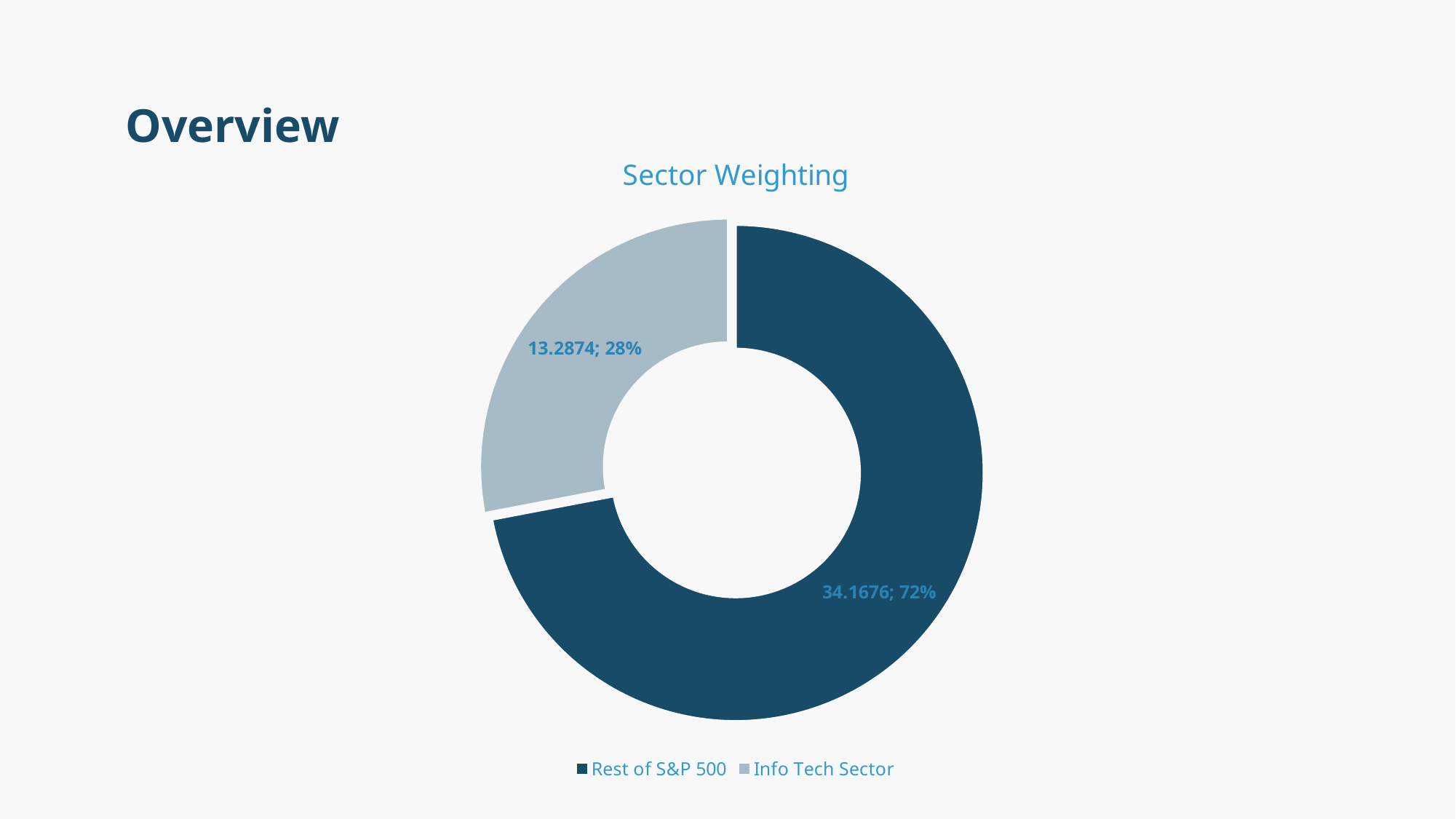
Which category is shown in the light grey-blue colour? Info Tech Sector What share of the chart does Rest of S&P 500 represent? 72% What is the difference between the values for Rest of S&P 500 and Info Tech Sector? 20.8802 What is the title of the chart? Sector Weighting Which category has the largest slice? Rest of S&P 500 Which category has the smallest slice? Info Tech Sector What share of the chart does Info Tech Sector represent? 28% How many categories does the chart show? 2 What kind of chart is shown on the slide? Doughnut (pie) chart Which is larger, Rest of S&P 500 or Info Tech Sector? Rest of S&P 500 What is the value for Info Tech Sector? 13.2874 What is the value for Rest of S&P 500? 34.1676